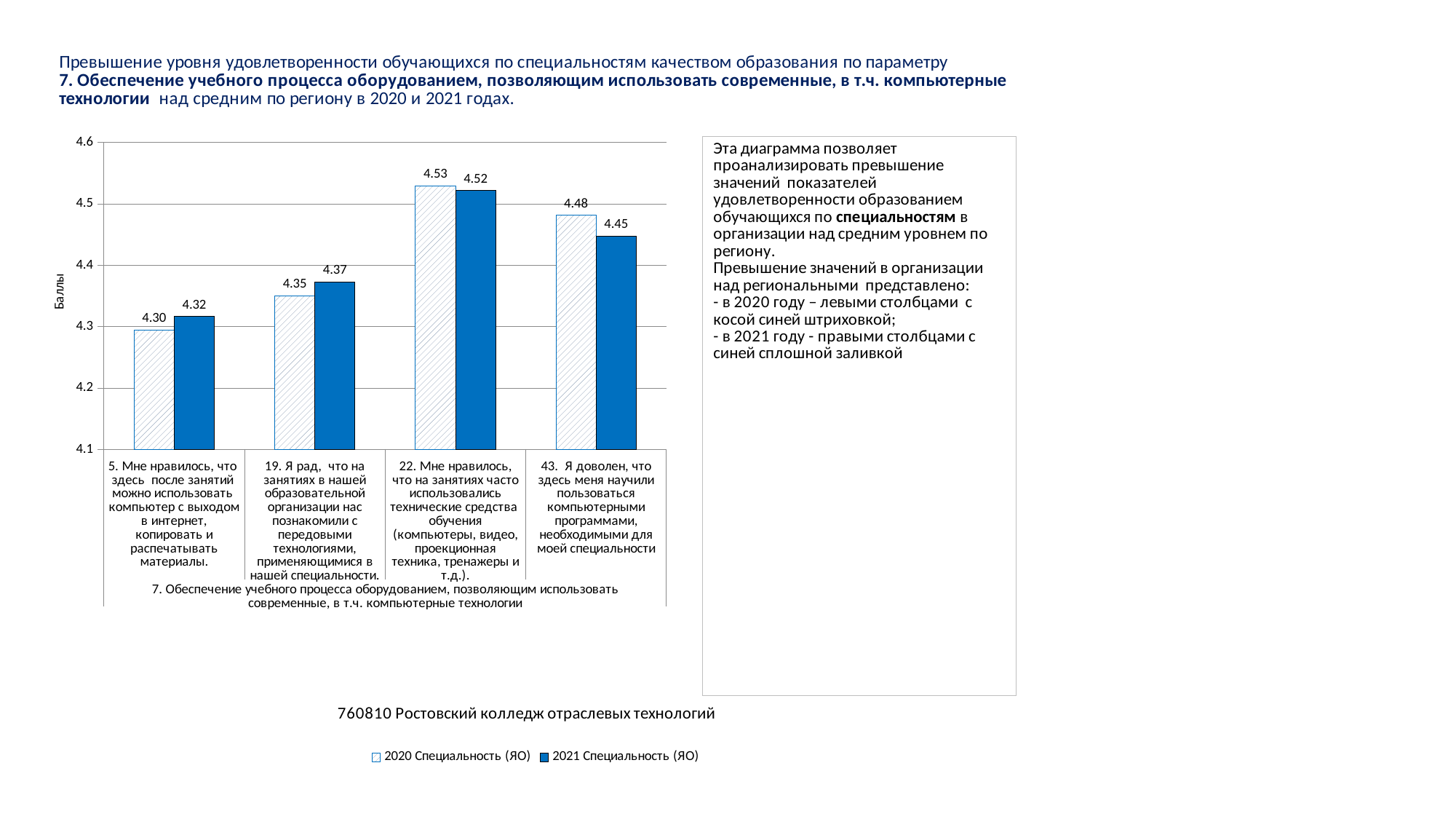
How many series does the legend list? 2 What is the value of the 2020 Специальность (ЯО) series for statement 5 ("Мне нравилось, что здесь после занятий можно использовать компьютер...")? 4.30 What is the label of the y axis? Баллы For statement 22, which is larger: the 2020 value or the 2021 value? 2020 (4.53) Is the 2020 value for statement 19 greater or less than 4.4? less Which statement has the lowest value in the 2021 Специальность (ЯО) series? 5. Мне нравилось, что здесь после занятий можно использовать компьютер с выходом в интернет How many categories (statements) are shown on the x axis? 4 What is the value of the 2021 Специальность (ЯО) series for statement 19 ("Я рад, что на занятиях в нашей образовательной организации нас познакомили с передовыми технологиями...")? 4.37 What type of chart is shown on the slide? bar chart What is the value of the 2021 Специальность (ЯО) series for statement 43 ("Я доволен, что здесь меня научили пользоваться компьютерными программами...")? 4.45 What is the difference between the 2020 and 2021 values for statement 43? 0.03 Which statement has the highest value in the 2020 Специальность (ЯО) series? 22. Мне нравилось, что на занятиях часто использовались технические средства обучения